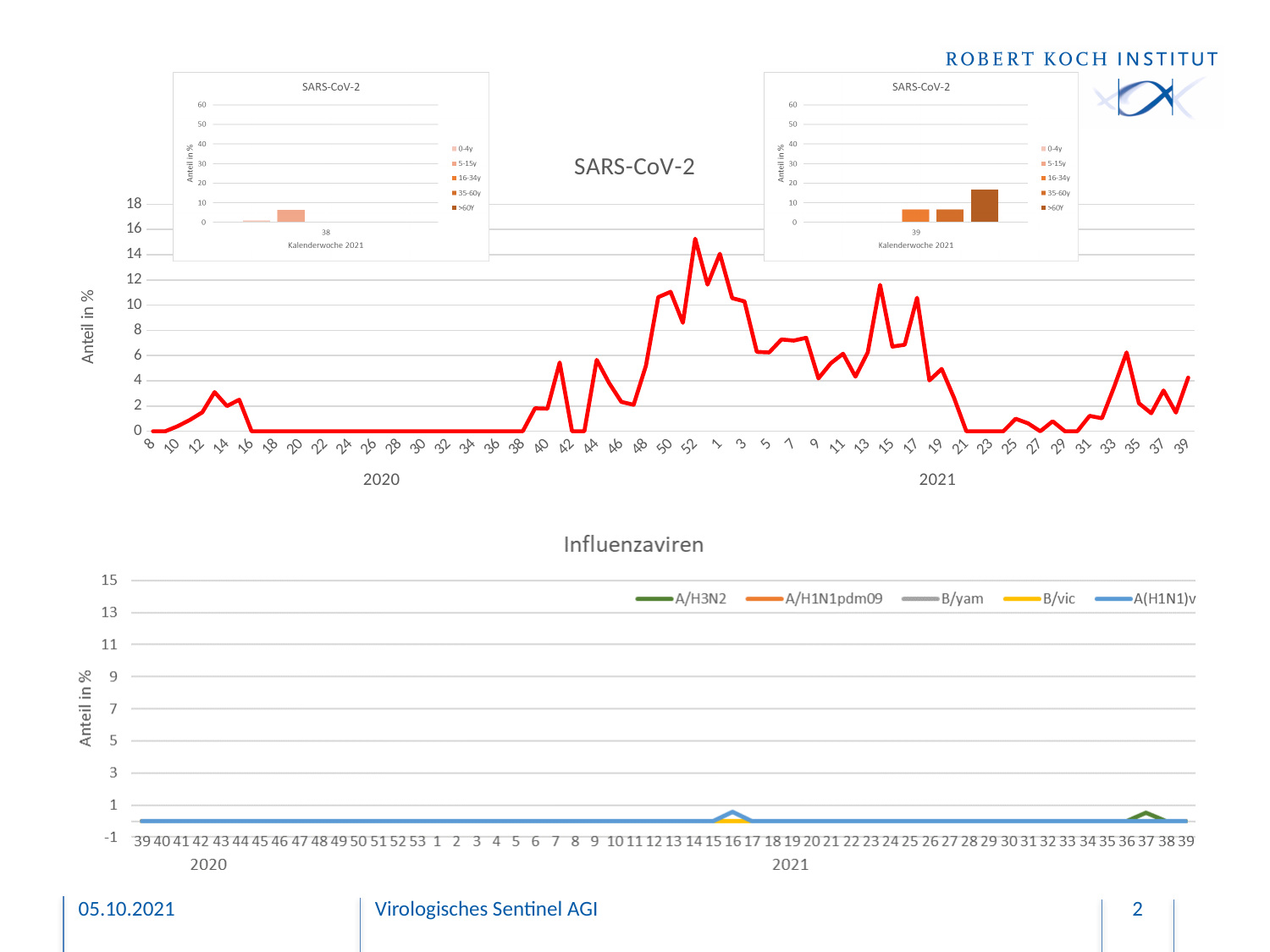
In the large SARS-CoV-2 line chart, which is larger: the value at week 52 of 2020 or the value at week 15 of 2021? week 52 of 2020 What kind of chart is the small inset chart for Kalenderwoche 39 (top right)? bar chart In the small inset SARS-CoV-2 chart for Kalenderwoche 39, which age group has the highest bar? >60Y What is the y-axis label of the large SARS-CoV-2 line chart? Anteil in % In the Influenzaviren chart, is the value for A/H3N2 at week 37 of 2021 greater or less than 3? less In the small inset SARS-CoV-2 chart for Kalenderwoche 39, is the value for 35-60y greater or less than 10? less In the large SARS-CoV-2 line chart, do the values rise or fall between calendar week 8 and calendar week 14 of 2020? rise How many series does the legend of the Influenzaviren chart list? 5 In the large SARS-CoV-2 line chart, is the value at calendar week 22 of 2021 greater or less than 2? less How many series does the legend of the small inset SARS-CoV-2 chart for Kalenderwoche 39 list? 5 What kind of chart is the large SARS-CoV-2 chart in the upper half of the slide? line chart